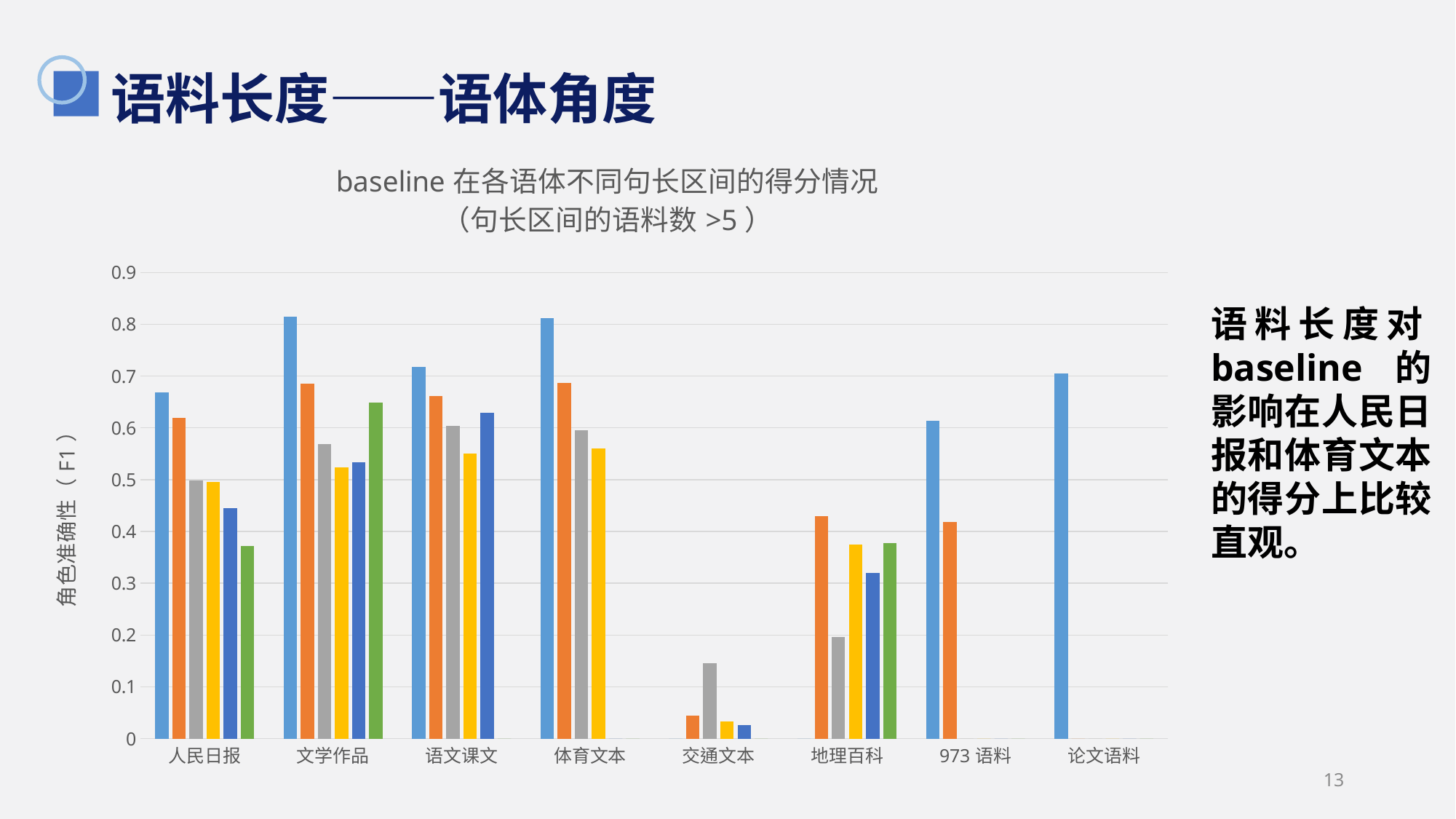
How many categories are shown on the x axis of the chart? 8 What is the label of the y axis of the chart? 角色准确性（F1） Which category has a larger blue (first) bar, 人民日报 or 文学作品? 文学作品 Which category has the lowest bars overall in the chart? 交通文本 Is the value of the orange (second) bar for 地理百科 greater or less than 0.4? greater Is the value of the green (last) bar for 人民日报 greater or less than 0.4? less How many bars are plotted for the category 973 语料? 2 Which category has a larger orange (second) bar, 人民日报 or 地理百科? 人民日报 Is the value of the orange (second) bar for 交通文本 greater or less than 0.1? less What is the title of the chart? baseline 在各语体不同句长区间的得分情况（句长区间的语料数 >5） What kind of chart is shown on the slide? bar chart